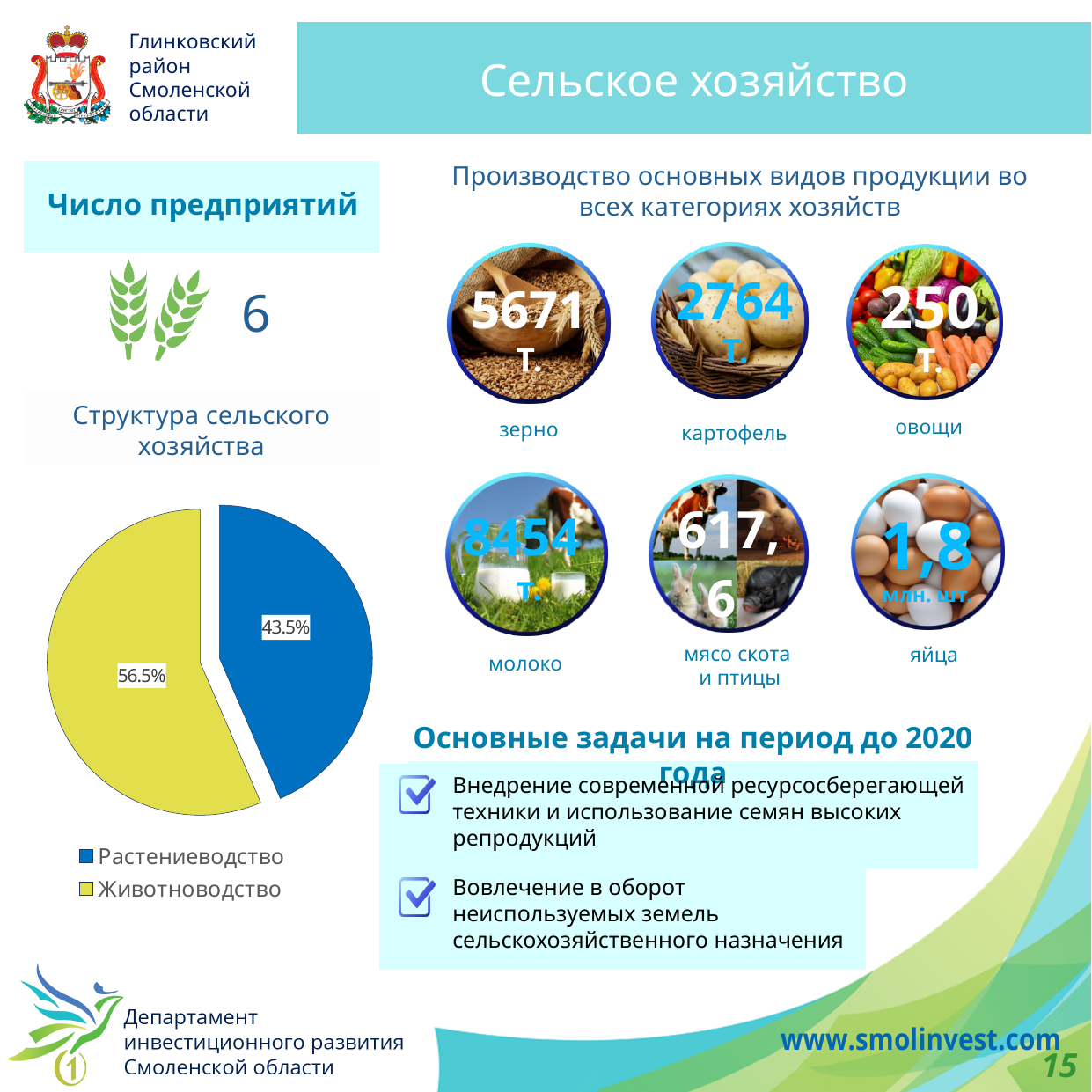
In the pie chart 'Структура сельского хозяйства', what is the difference in percentage points between Животноводство and Растениеводство? 13 percentage points How many entries does the legend of the pie chart 'Структура сельского хозяйства' list? 2 How many slices does the pie chart 'Структура сельского хозяйства' have? 2 In the pie chart 'Структура сельского хозяйства', what colour is the Животноводство slice? yellow In the pie chart 'Структура сельского хозяйства', which is larger: Растениеводство or Животноводство? Животноводство In the pie chart 'Структура сельского хозяйства', what share does Растениеводство have? 43.5% In the pie chart 'Структура сельского хозяйства', what colour is the Растениеводство slice? blue In the pie chart 'Структура сельского хозяйства', which category has the largest share? Животноводство In the pie chart 'Структура сельского хозяйства', what share does Животноводство have? 56.5% In the pie chart 'Структура сельского хозяйства', which category has the smallest share? Растениеводство In the pie chart 'Структура сельского хозяйства', is the share of Растениеводство greater or less than 50%? less What kind of chart is shown under the heading 'Структура сельского хозяйства'? pie chart